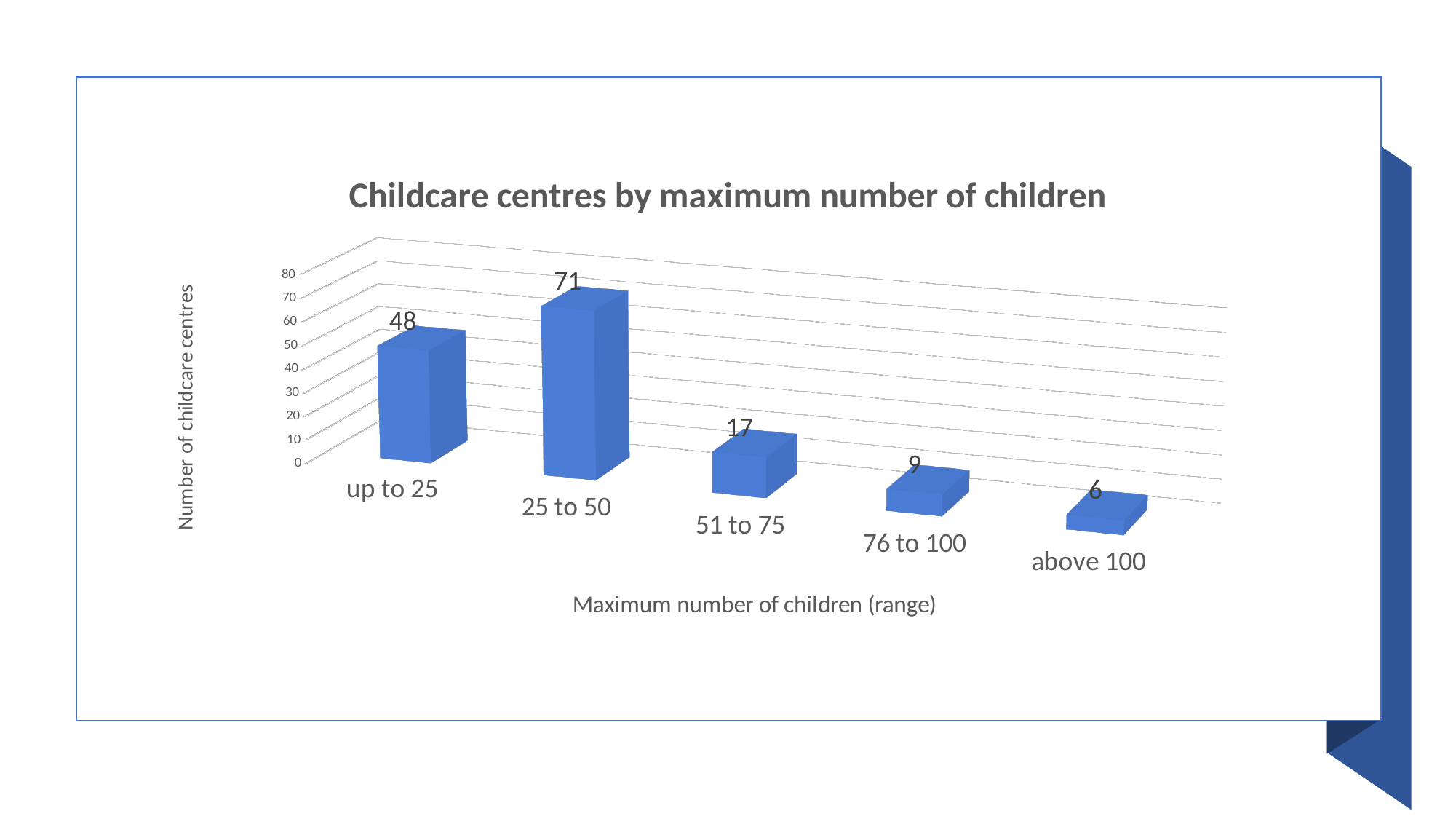
Which category has the highest number of childcare centres? 25 to 50 What is the number of childcare centres for the 'up to 25' category? 48 Which category has the lowest number of childcare centres? above 100 What is the title of the chart? Childcare centres by maximum number of children What is the difference between the number of childcare centres for '25 to 50' and 'up to 25'? 23 What is the number of childcare centres for the '25 to 50' category? 71 How many categories are shown on the x axis? 5 What kind of chart is shown on the slide? bar chart What is the number of childcare centres for the '51 to 75' category? 17 What is the number of childcare centres for the 'above 100' category? 6 What is the difference between the number of childcare centres for '51 to 75' and '76 to 100'? 8 Which category has more childcare centres, '76 to 100' or 'above 100'? 76 to 100